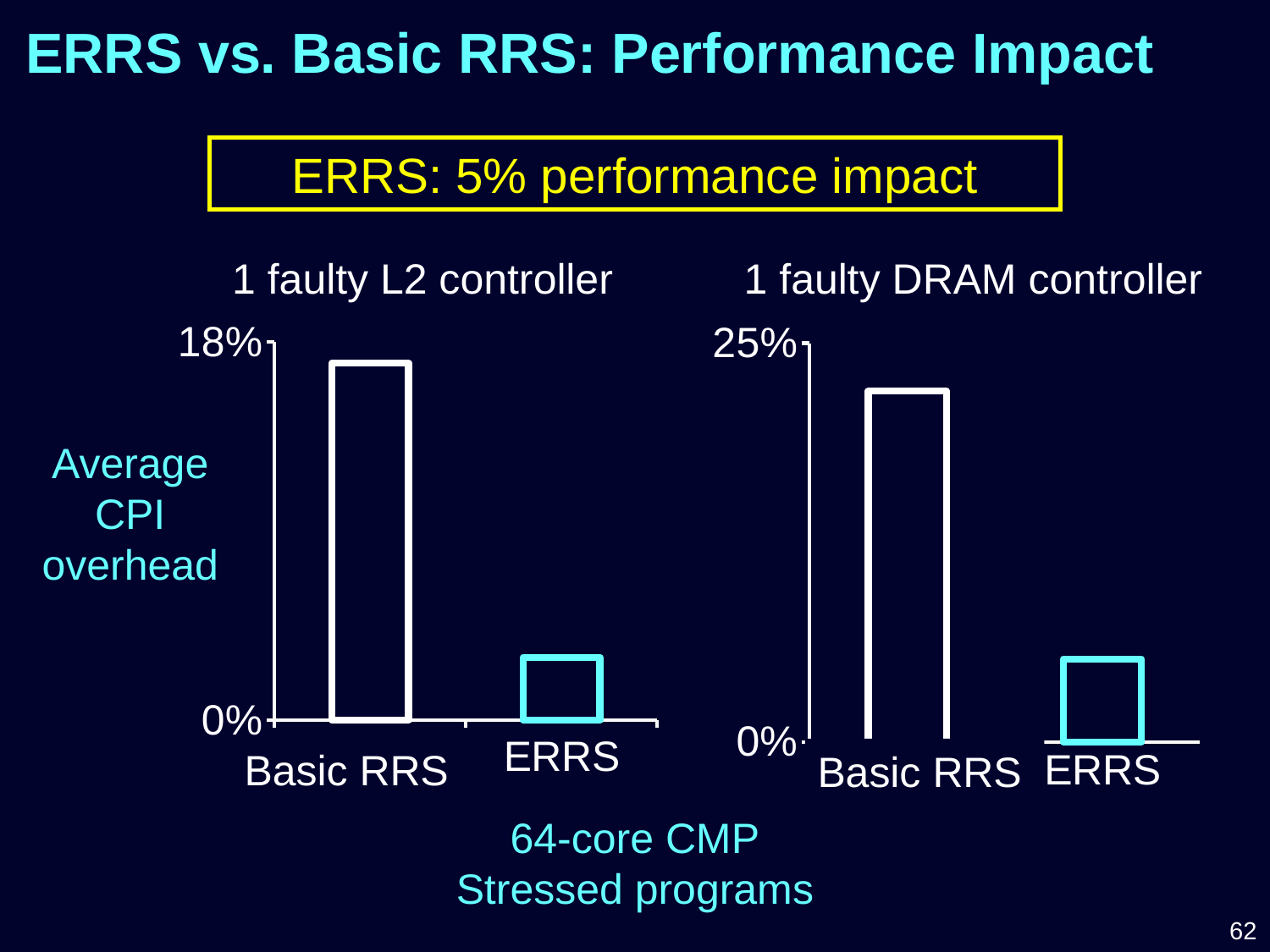
In the '1 faulty L2 controller' chart, how many bars are plotted? 2 What kind of chart is the '1 faulty DRAM controller' chart? bar chart In the '1 faulty L2 controller' chart, which category has the lowest average CPI overhead? ERRS In the '1 faulty DRAM controller' chart, which category has the highest average CPI overhead? Basic RRS What is the label on the y axis of the charts? Average CPI overhead In the '1 faulty L2 controller' chart, which category has the highest average CPI overhead? Basic RRS In the '1 faulty DRAM controller' chart, how many categories are shown on the x axis? 2 What kind of chart is the '1 faulty L2 controller' chart? bar chart In the '1 faulty DRAM controller' chart, is the value for Basic RRS greater or less than 25%? less In the '1 faulty DRAM controller' chart, which category has the lowest average CPI overhead? ERRS In the '1 faulty L2 controller' chart, is the value for ERRS greater or less than 18%? less In the '1 faulty L2 controller' chart, which is larger, the value for Basic RRS or the value for ERRS? Basic RRS